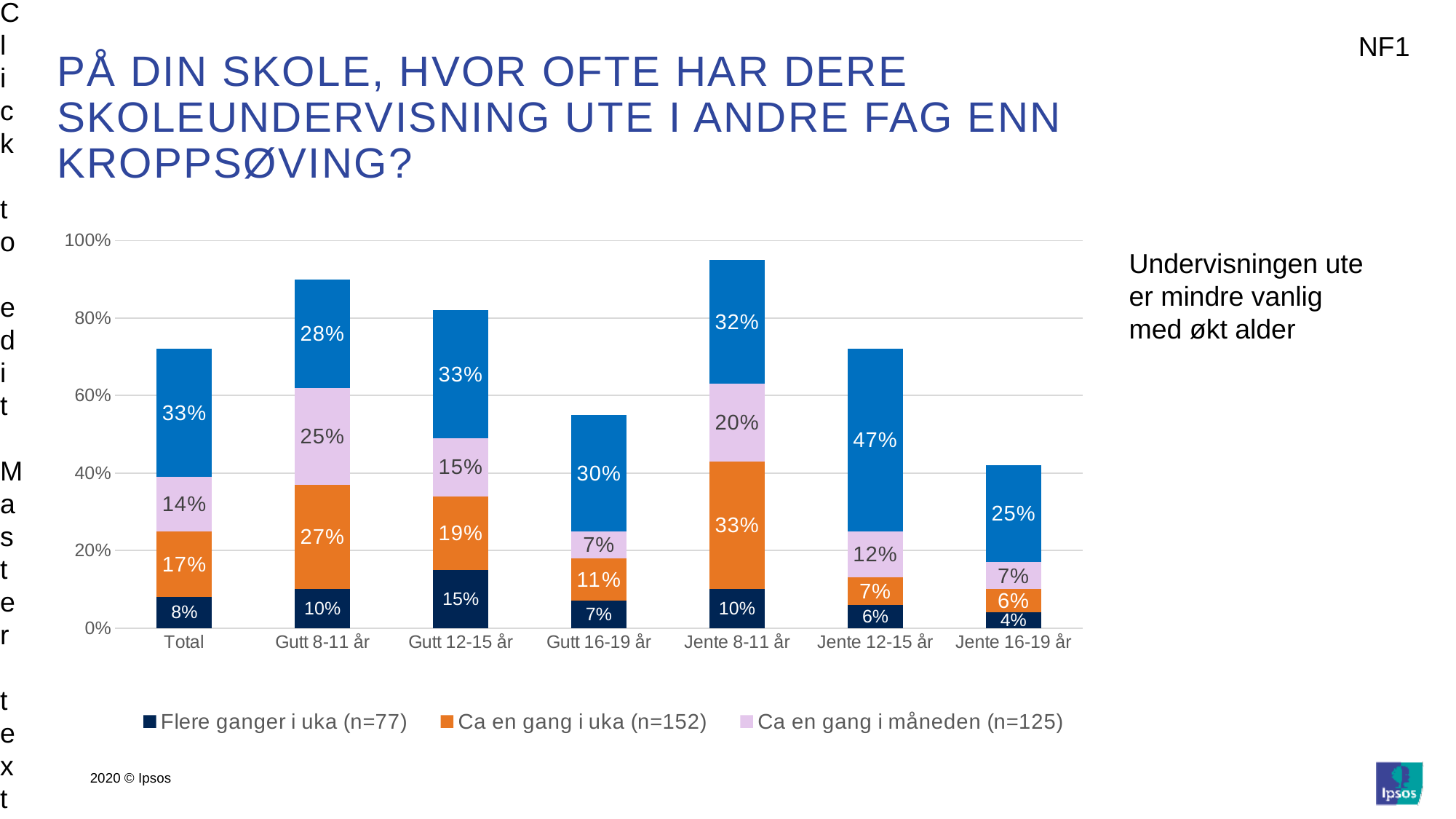
What is the total of the stacked bar for Jente 8-11 år? 95% Which category has the highest value for Flere ganger i uka? Gutt 12-15 år How many series does the legend list? 3 Which has the larger Ca en gang i uka value, Gutt 8-11 år or Gutt 12-15 år? Gutt 8-11 år What is the value for Ca en gang i måneden for Gutt 8-11 år? 25% What is the value for Ca en gang i uka for Jente 8-11 år? 33% How many categories are shown on the x axis? 7 What is the value for Flere ganger i uka for Gutt 12-15 år? 15% Which category has the lowest value for Ca en gang i uka? Jente 16-19 år Is the total height of the stacked bar for Gutt 16-19 år greater or less than 60%? less What is the difference between the Ca en gang i måneden values for Gutt 8-11 år and Jente 16-19 år? 18 percentage points What kind of chart is shown on the slide? Stacked bar chart